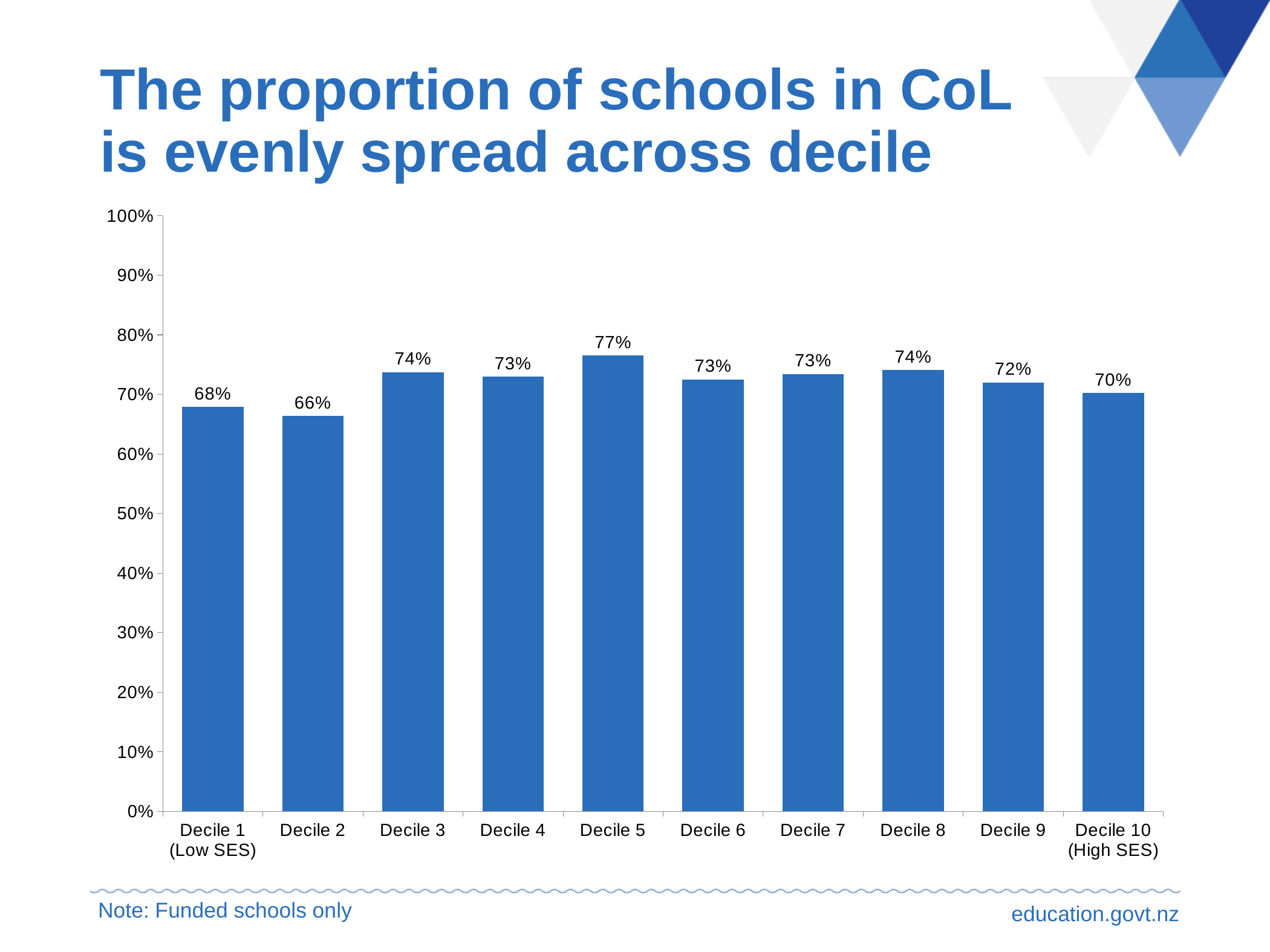
Which is larger, the value for Decile 3 or the value for Decile 9? Decile 3 What is the difference between the values for Decile 5 and Decile 2? 11% What is the value for Decile 5? 77% What kind of chart is shown on the slide? bar chart What is the value for Decile 10 (High SES)? 70% What is the difference between the values for Decile 1 (Low SES) and Decile 10 (High SES)? 2% How many deciles are shown on the x axis? 10 Is the value for Decile 2 greater or less than 70%? less What is the value for Decile 9? 72% Which decile has the lowest proportion of schools in CoL? Decile 2 Which decile has the highest proportion of schools in CoL? Decile 5 What is the value for Decile 1 (Low SES)? 68%